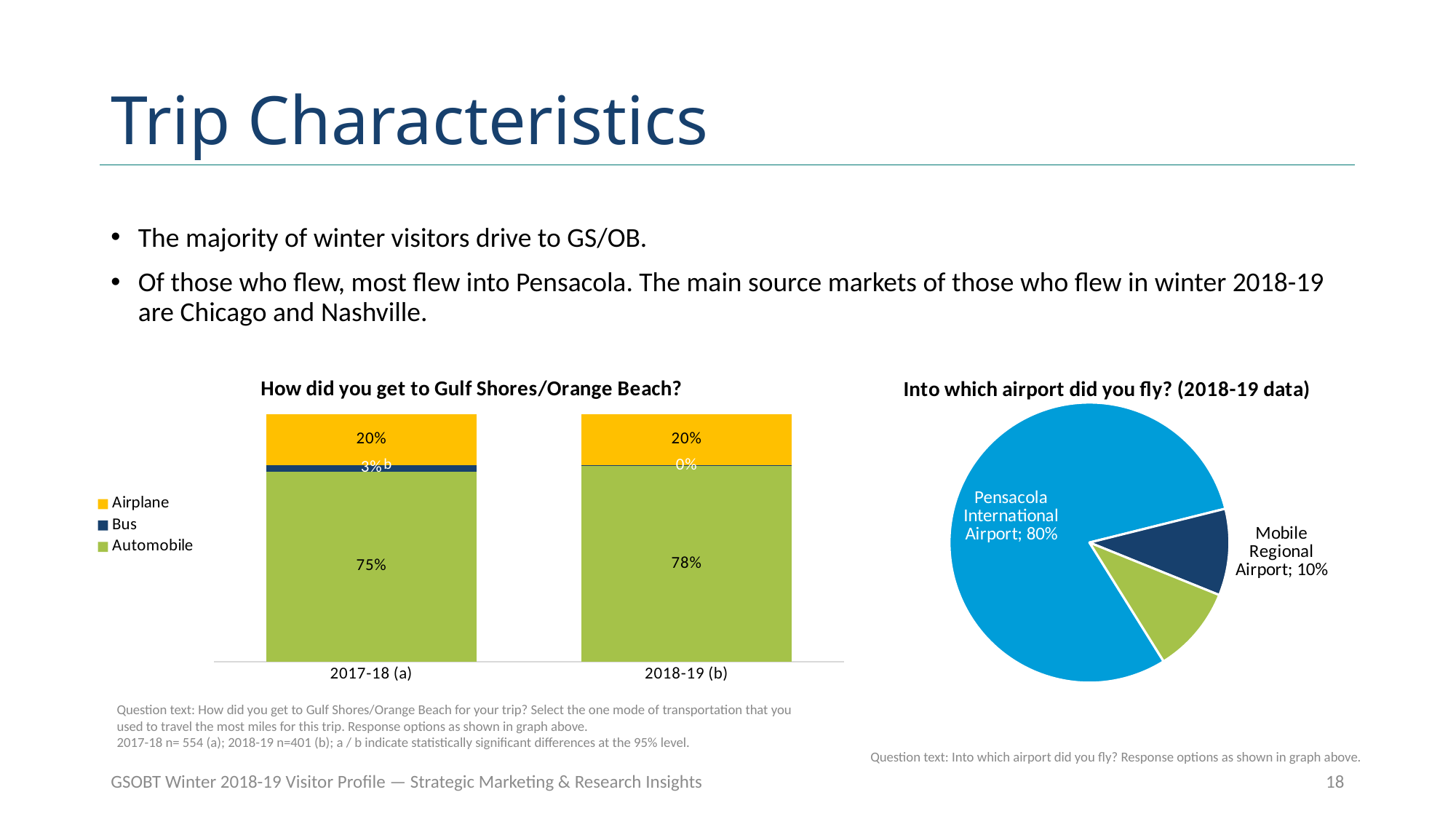
In the pie chart 'Into which airport did you fly? (2018-19 data)', what share of visitors flew into Pensacola International Airport? 80% In the chart 'How did you get to Gulf Shores/Orange Beach?', what percentage of 2017-18 (a) visitors arrived by Bus? 3% In the chart 'How did you get to Gulf Shores/Orange Beach?', which mode of transportation has the smallest share in 2017-18 (a)? Bus What kind of chart is 'How did you get to Gulf Shores/Orange Beach?'? Stacked bar chart In the chart 'How did you get to Gulf Shores/Orange Beach?', which mode of transportation has the largest share in 2018-19 (b)? Automobile In the pie chart 'Into which airport did you fly? (2018-19 data)', which is larger: the share for Pensacola International Airport or Mobile Regional Airport? Pensacola International Airport In the chart 'How did you get to Gulf Shores/Orange Beach?', what percentage of 2018-19 (b) visitors arrived by Automobile? 78% In the chart 'How did you get to Gulf Shores/Orange Beach?', what is the difference in the Automobile share between 2018-19 (b) and 2017-18 (a)? 3 percentage points In the chart 'How did you get to Gulf Shores/Orange Beach?', what percentage of 2018-19 (b) visitors arrived by Airplane? 20% How many series does the legend of the chart 'How did you get to Gulf Shores/Orange Beach?' list? 3 In the pie chart 'Into which airport did you fly? (2018-19 data)', what share of visitors flew into Mobile Regional Airport? 10% In the chart 'How did you get to Gulf Shores/Orange Beach?', what percentage of 2017-18 (a) visitors arrived by Automobile? 75%